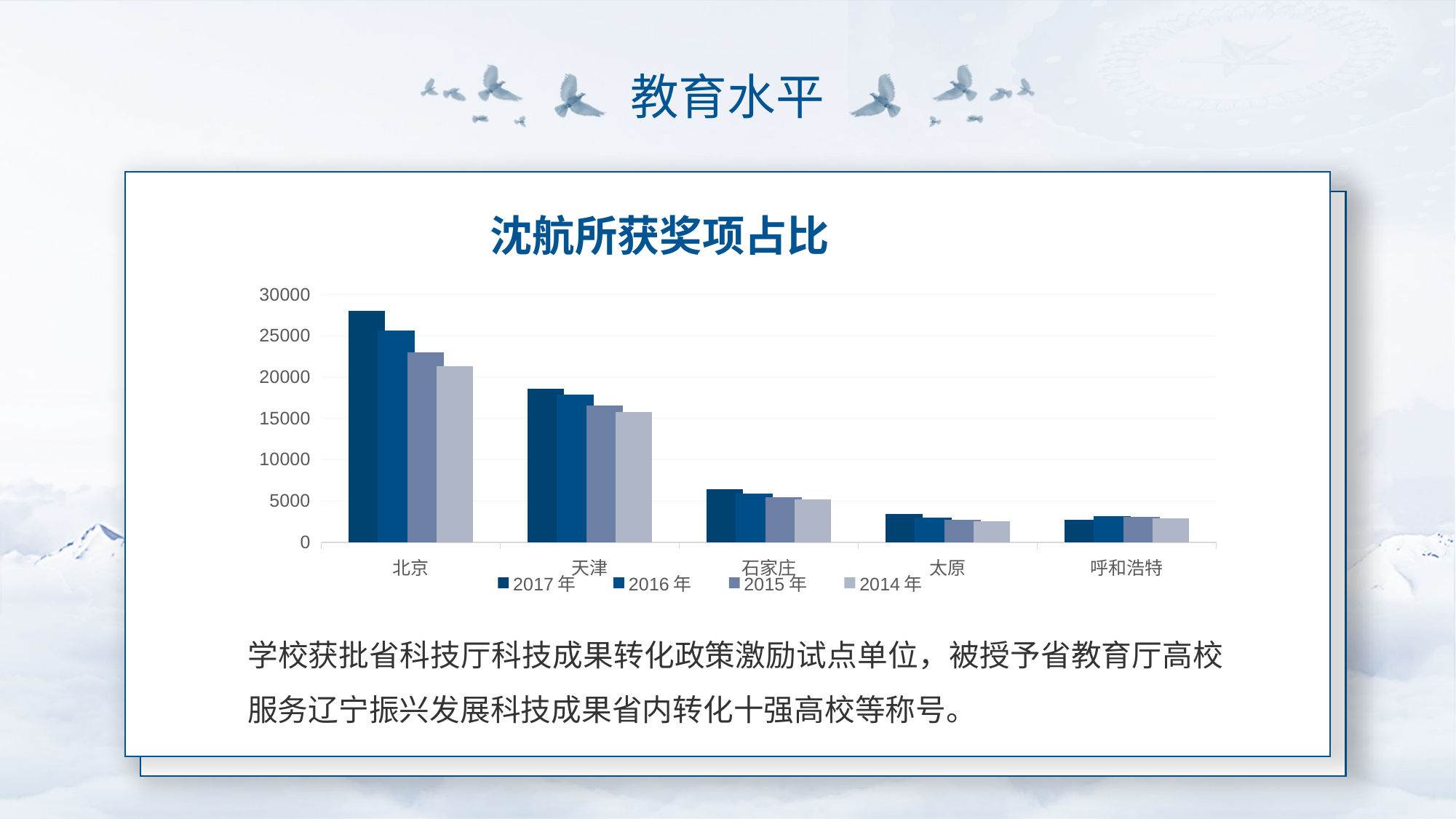
Which category has the highest values in the chart? 北京 Is the value for 太原 in 2017 年 greater or less than 5000? less What kind of chart is shown on the slide? bar chart Is the value for 天津 in 2017 年 greater or less than 15000? greater Which category has the lowest value for the 2017 年 series? 呼和浩特 Is the value for 北京 in 2017 年 greater or less than 25000? greater How many categories are shown on the x axis? 5 Within the 北京 category, do the values rise or fall from 2017 年 to 2014 年? fall How many series does the legend list? 4 What is the title of the chart? 沈航所获奖项占比 Which is larger for 2017 年: 北京 or 天津? 北京